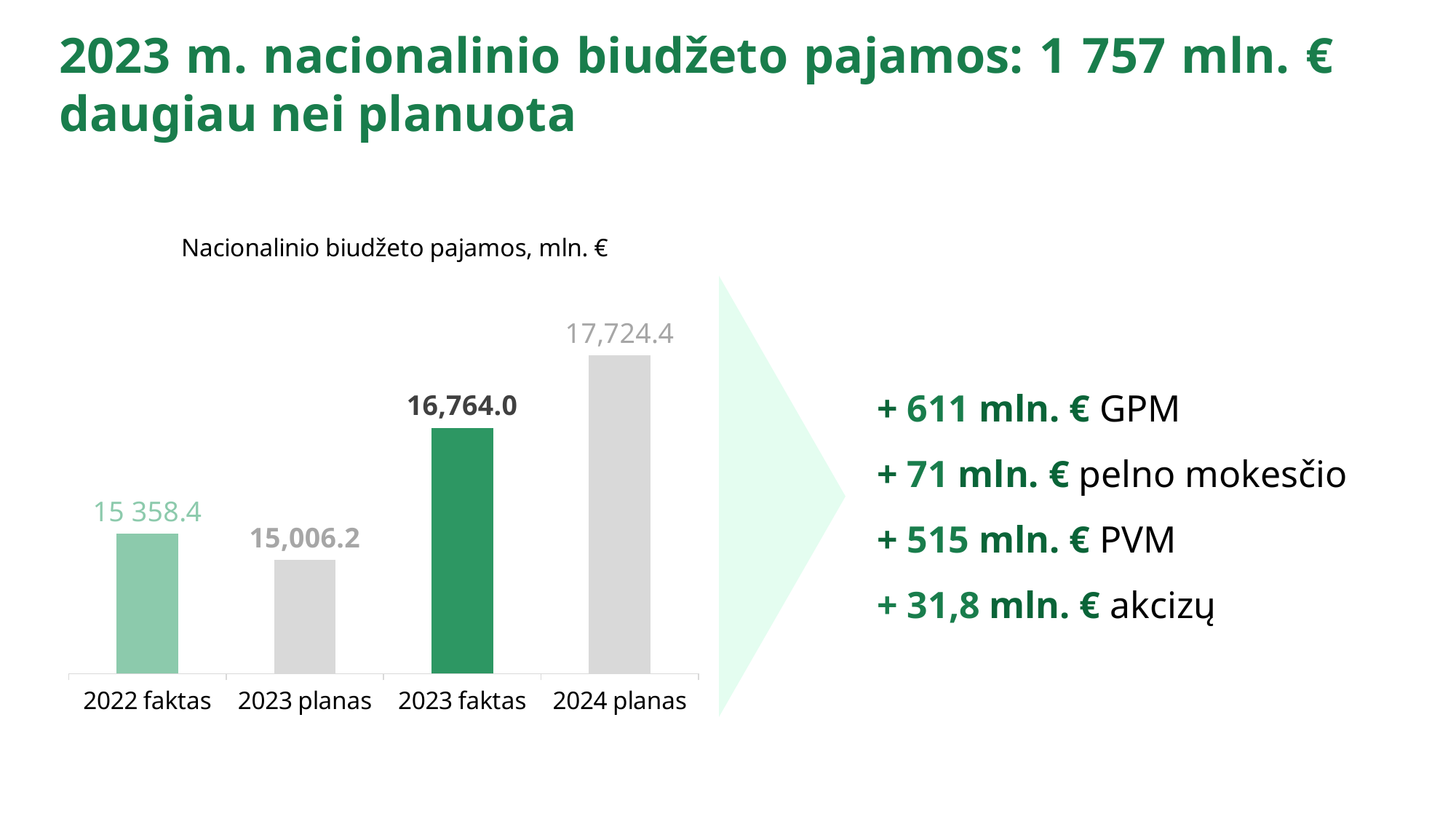
Which is larger, the value for 2022 faktas or the value for 2023 planas? 2022 faktas Which category has the lowest value? 2023 planas What is the title of the chart? Nacionalinio biudžeto pajamos, mln. € What is the difference between the values for 2023 faktas and 2023 planas? 1,757.8 Which category has the highest value? 2024 planas What is the value for 2023 planas? 15,006.2 How many categories are shown in the chart? 4 What is the difference between the values for 2024 planas and 2023 faktas? 960.4 What kind of chart is shown on the slide? bar chart What is the value for 2024 planas? 17,724.4 What is the value for 2023 faktas? 16,764.0 What is the value for 2022 faktas? 15 358.4